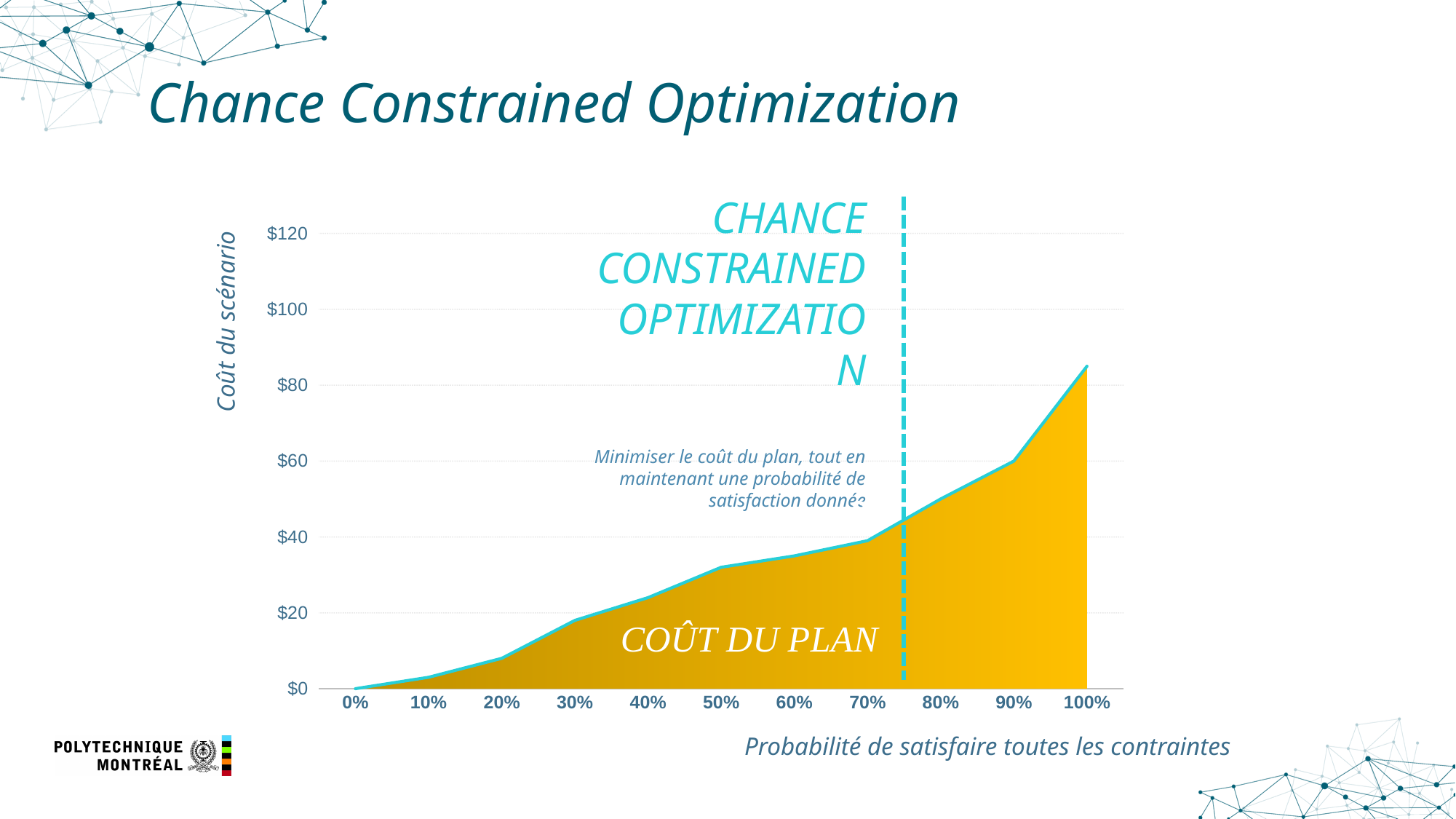
How many probability points are labelled on the x axis? 11 What is the scenario cost at 0% probability? $0 What kind of chart is shown on the slide? area chart Is the scenario cost at 100% probability greater or less than $80? greater What is the title of the y axis? Coût du scénario Which has a higher scenario cost, 80% probability or 60% probability? 80% Do the values rise or fall as the probability increases along the x axis? rise Is the scenario cost at 50% probability greater or less than $20? greater Is the scenario cost at 20% probability greater or less than $20? less At which probability is the scenario cost lowest? 0% At which probability is the scenario cost highest? 100%